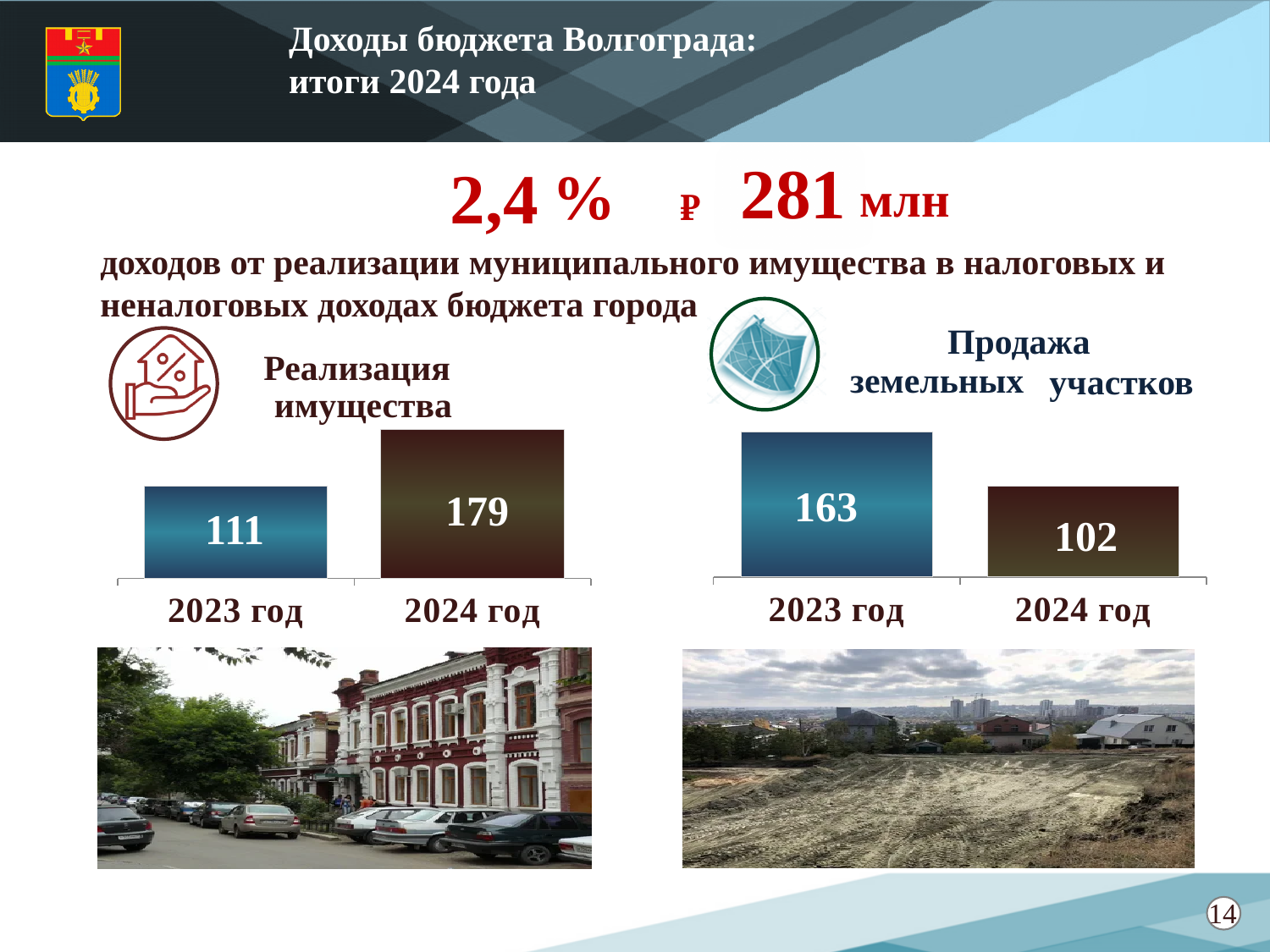
In the 'Реализация имущества' chart, what is the difference between the 2024 год and 2023 год values? 68 In the 'Продажа земельных участков' chart, what is the value for 2024 год? 102 In the 'Продажа земельных участков' chart, do the values rise or fall from 2023 год to 2024 год? fall In the 'Реализация имущества' chart, which year has the higher value? 2024 год In the 'Реализация имущества' chart, what is the value for 2024 год? 179 In the 'Продажа земельных участков' chart, what is the value for 2023 год? 163 Which is larger: the 2024 год value in the 'Реализация имущества' chart or the 2024 год value in the 'Продажа земельных участков' chart? Реализация имущества (179) What kind of chart is the 'Продажа земельных участков' chart? bar chart In the 'Продажа земельных участков' chart, which year has the lower value? 2024 год In the 'Продажа земельных участков' chart, what is the difference between the 2023 год and 2024 год values? 61 In the 'Реализация имущества' chart, what is the value for 2023 год? 111 How many categories does the 'Реализация имущества' chart show? 2